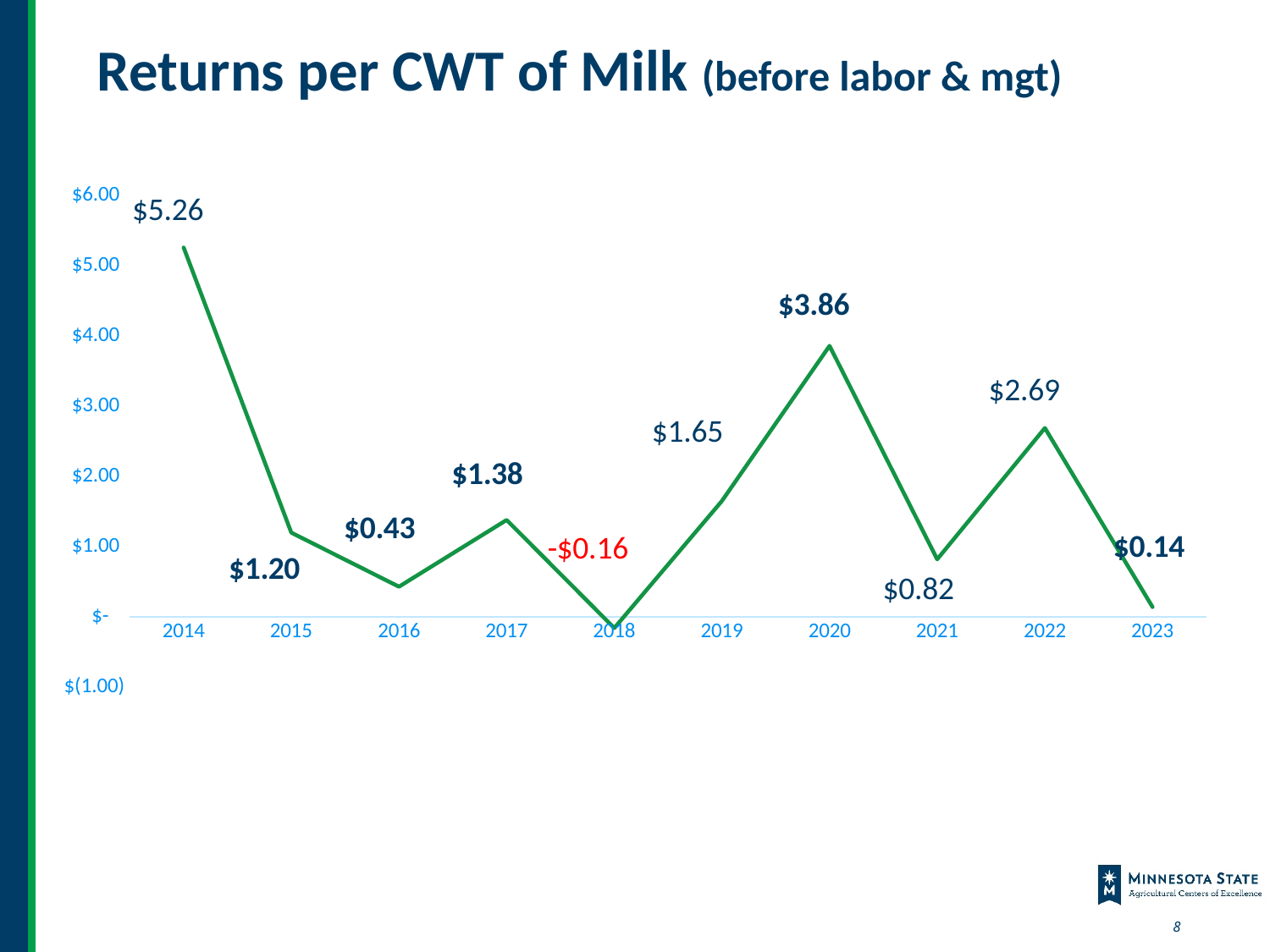
Which year has the highest return per CWT of milk? 2014 What is the return per CWT of milk in 2020? $3.86 Is the return per CWT of milk in 2017 greater or less than $2.00? less What is the difference between the return per CWT in 2020 and in 2021? $3.04 How many years are plotted on the chart? 10 What is the return per CWT of milk in 2014? $5.26 What kind of chart is shown on the slide? line chart What is the return per CWT of milk in 2023? $0.14 Which year has the lowest return per CWT of milk? 2018 What is the title of the chart? Returns per CWT of Milk (before labor & mgt) What is the return per CWT of milk in 2018? -$0.16 Which year has a larger return per CWT of milk, 2019 or 2022? 2022